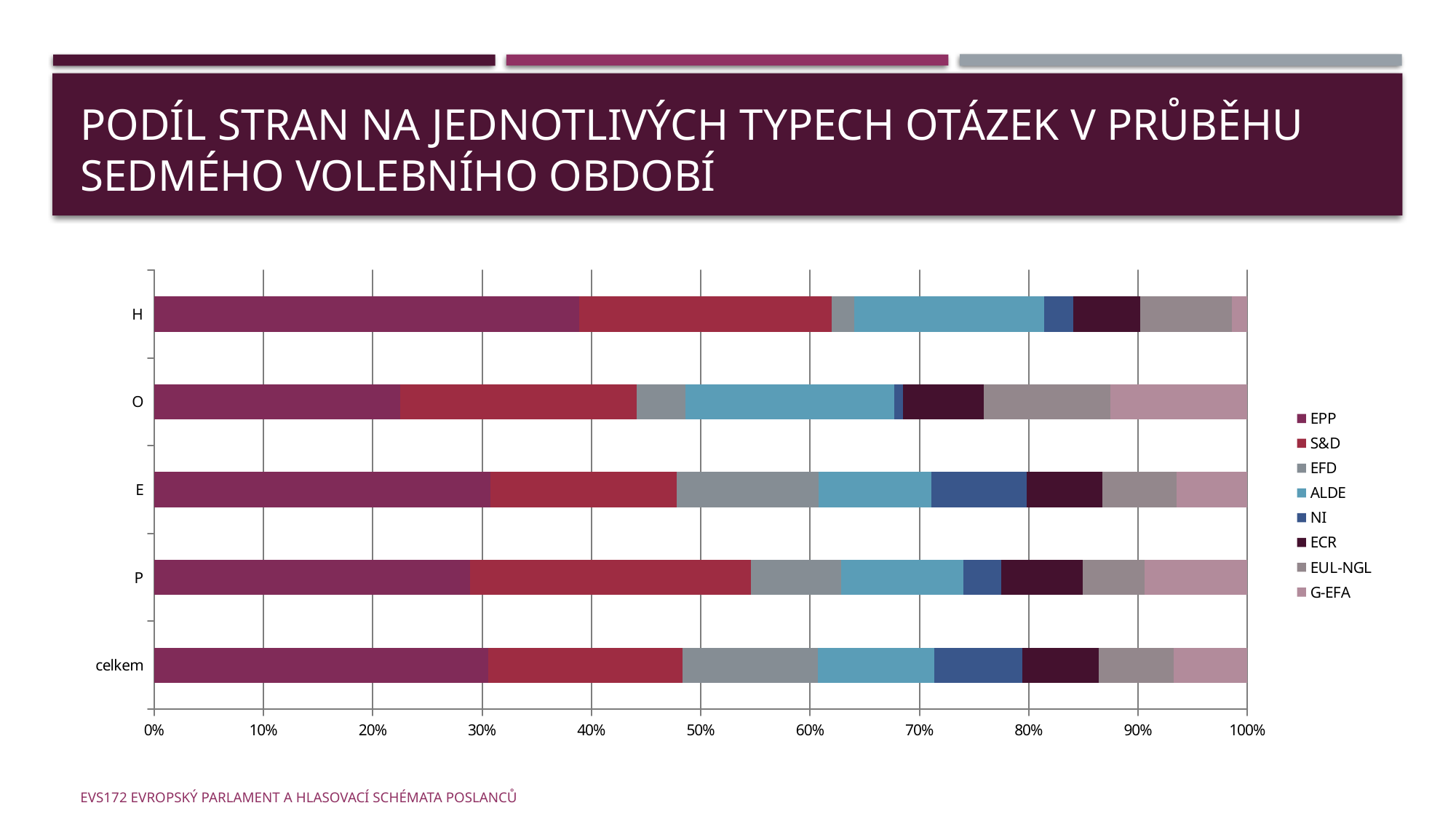
Which category has a larger G-EFA segment, O or H? O What kind of chart is shown on the slide? Stacked bar chart Which category has a larger NI segment, E or O? E What is the total of each stacked bar in the chart? 100% How many series does the chart legend list? 8 Which series is listed last in the chart legend? G-EFA Which category has the largest EPP segment? H Is the EPP share for category O greater or less than 30%? less Is the EPP share for category H greater or less than 30%? greater How many categories are shown on the vertical axis of the chart? 5 Which category has the smallest EPP segment? O Which series is listed first in the chart legend? EPP